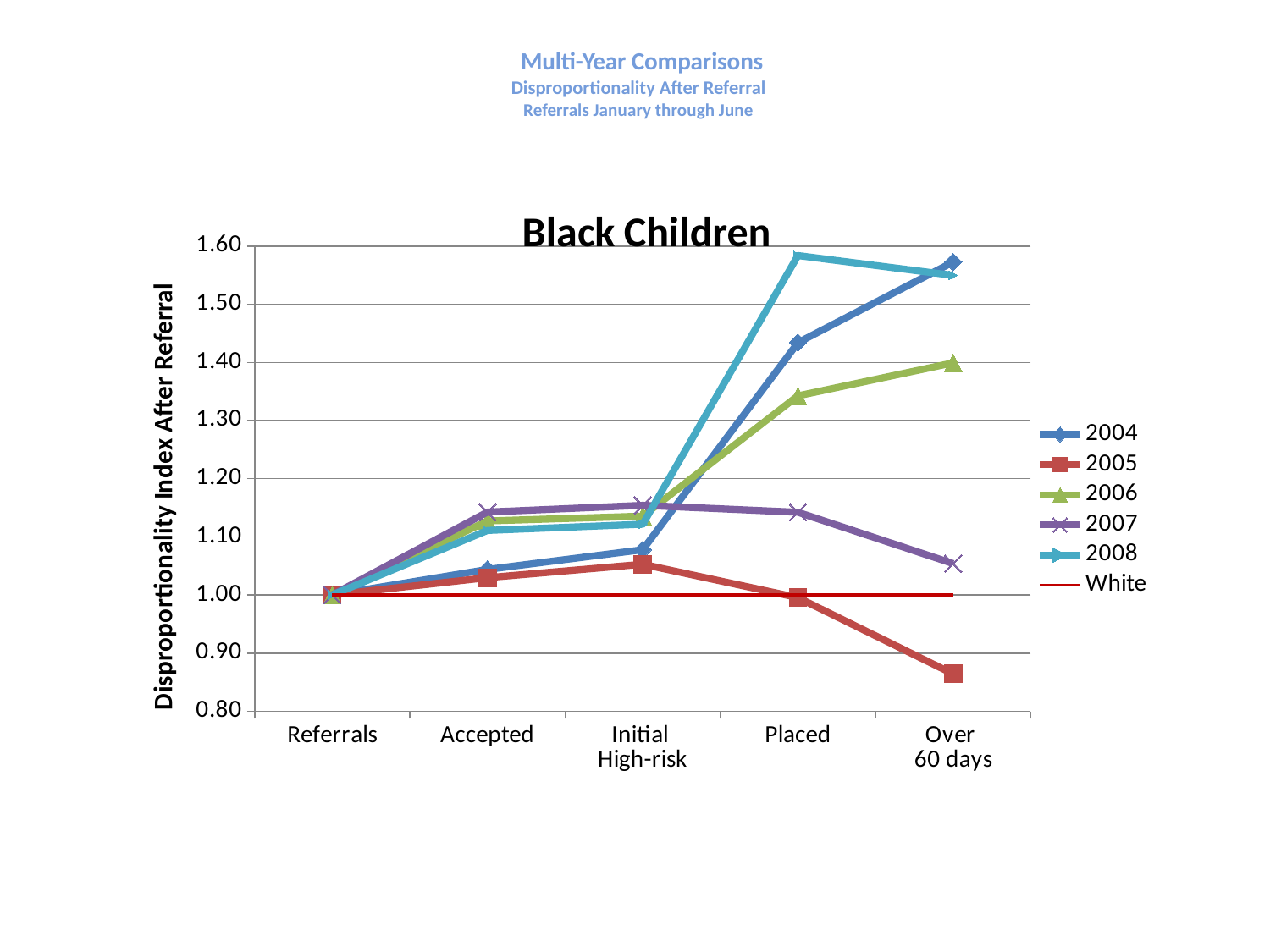
How many categories are shown on the x axis? 5 Which series has the lowest value at Over 60 days? 2005 How many series does the legend list? 6 Does the 2005 line rise or fall from Placed to Over 60 days? fall Is the value for 2005 at Over 60 days greater or less than 0.90? less Which series has the highest value at Placed? 2008 Is the value for 2006 at Placed greater or less than 1.30? greater What is the title of the chart? Black Children What kind of chart is shown on the slide? line chart Is the value for 2008 at Placed greater or less than 1.50? greater What is the value of the White line at Placed? 1.00 At Placed, which is larger: the value for 2004 or the value for 2006? 2004